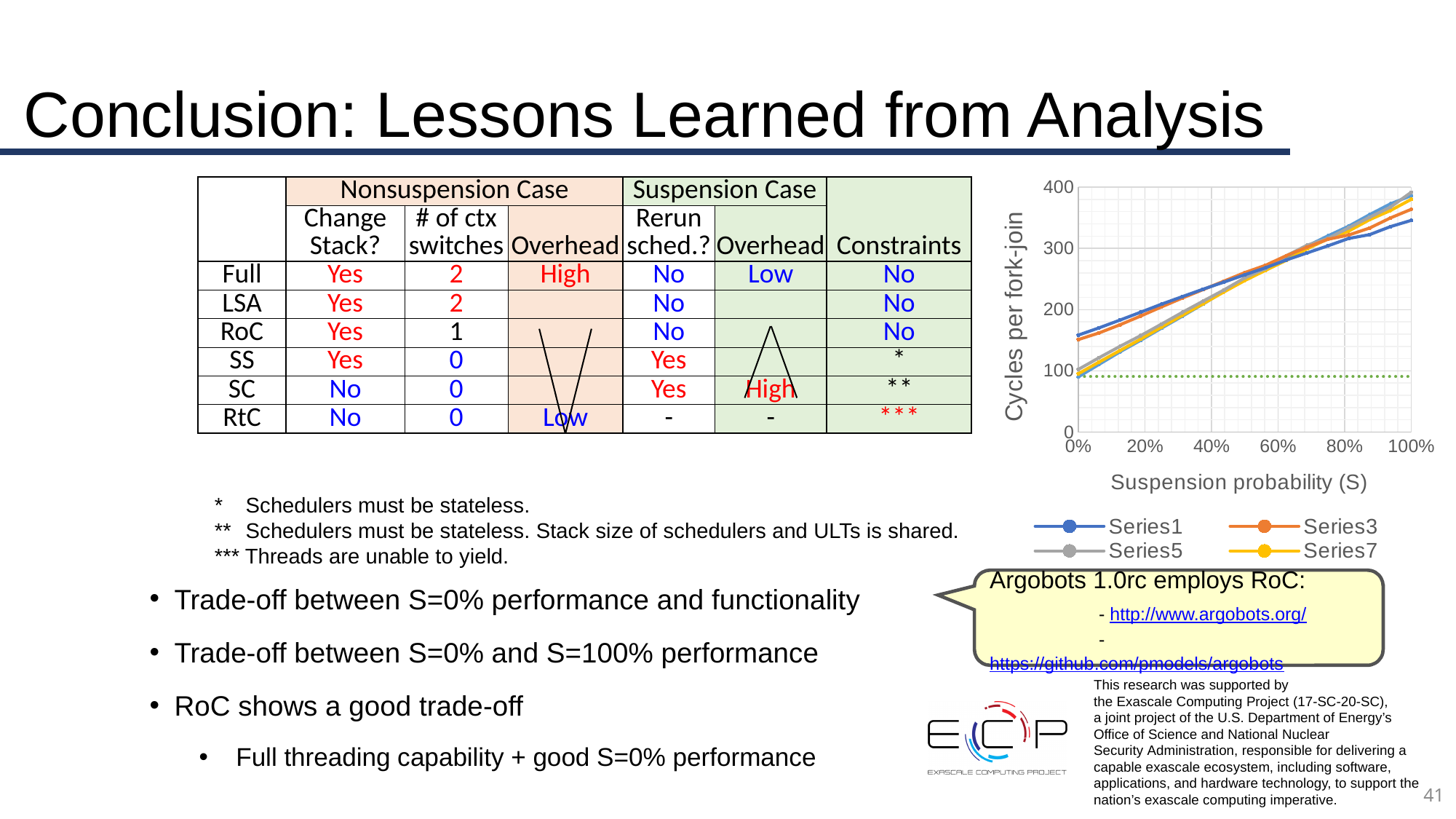
At 0% suspension probability, which is larger: Series1 or Series5? Series1 What is the title of the y axis of the chart? Cycles per fork-join Is the value for Series1 at 0% suspension probability greater or less than 100? greater Do the values of Series1 rise or fall as the suspension probability increases from 0% to 100%? rise What kind of chart is shown on the right side of the slide? line chart What is the title of the x axis of the chart? Suspension probability (S) Is the value for Series3 at 60% suspension probability greater or less than 200? greater At 100% suspension probability, which is larger: Series1 or Series5? Series5 Is the value for Series1 at 100% suspension probability greater or less than 300? greater Which series has the lowest value at 100% suspension probability? Series1 How many series does the legend of the chart list? 4